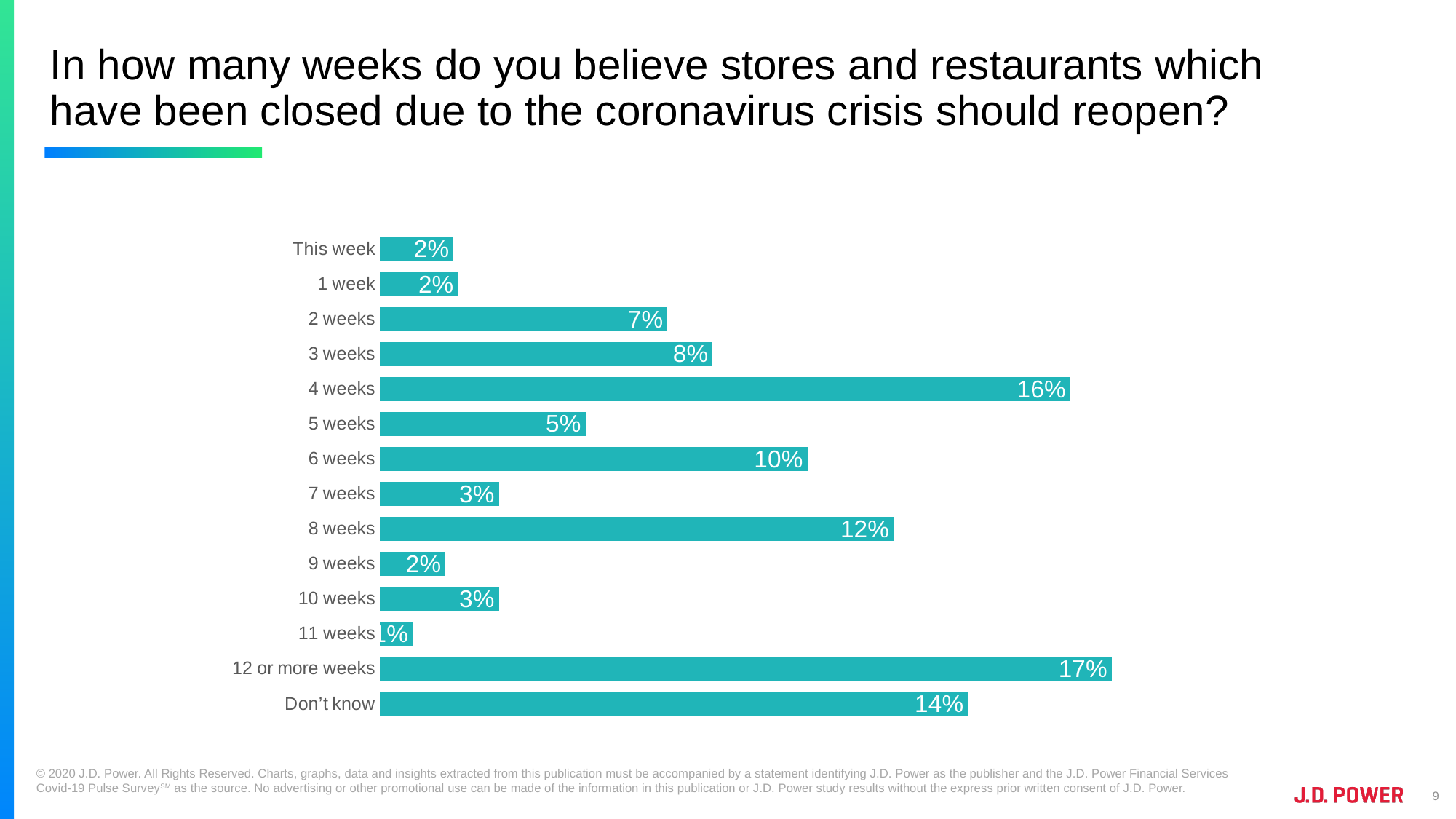
Which category has the highest value? 12 or more weeks Which is larger, the value for 2 weeks or the value for 3 weeks? 3 weeks What colour are the bars in the chart? Teal What is the difference between the values for 6 weeks and 5 weeks? 5% Which category has the lowest value? 11 weeks What percentage of respondents answered "Don't know"? 14% What percentage of respondents said 4 weeks? 16% Which is larger, the value for 8 weeks or the value for Don't know? Don't know What kind of chart is shown on the slide? Bar chart What is the value for 8 weeks? 12% What is the difference between the values for 12 or more weeks and 4 weeks? 1% How many categories are shown in the chart? 14